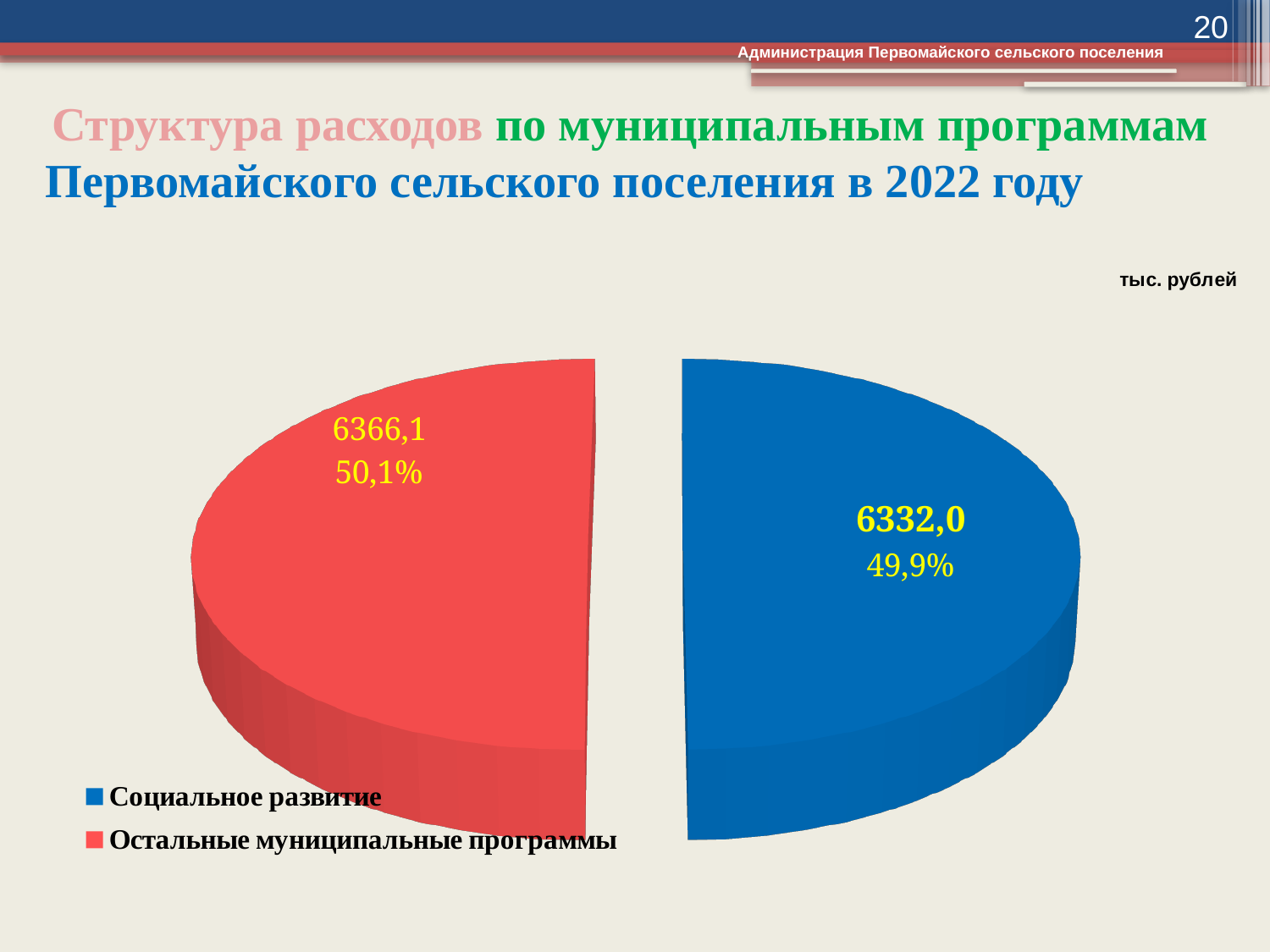
What is the difference between the values for Остальные муниципальные программы and Социальное развитие? 34,1 What colour is the slice for Социальное развитие? blue Which category has the larger value according to the data labels? Остальные муниципальные программы What is the value for Остальные муниципальные программы? 6366,1 Which is larger: the value for Социальное развитие or the value for Остальные муниципальные программы? Остальные муниципальные программы What is the total of the two slices in the pie chart? 12698,1 What is the value for Социальное развитие? 6332,0 How many slices does the pie chart have? 2 What share of the pie does Социальное развитие represent? 49,9% Which category has the smaller value according to the data labels? Социальное развитие What kind of chart is shown on the slide? pie chart What share of the pie does Остальные муниципальные программы represent? 50,1%